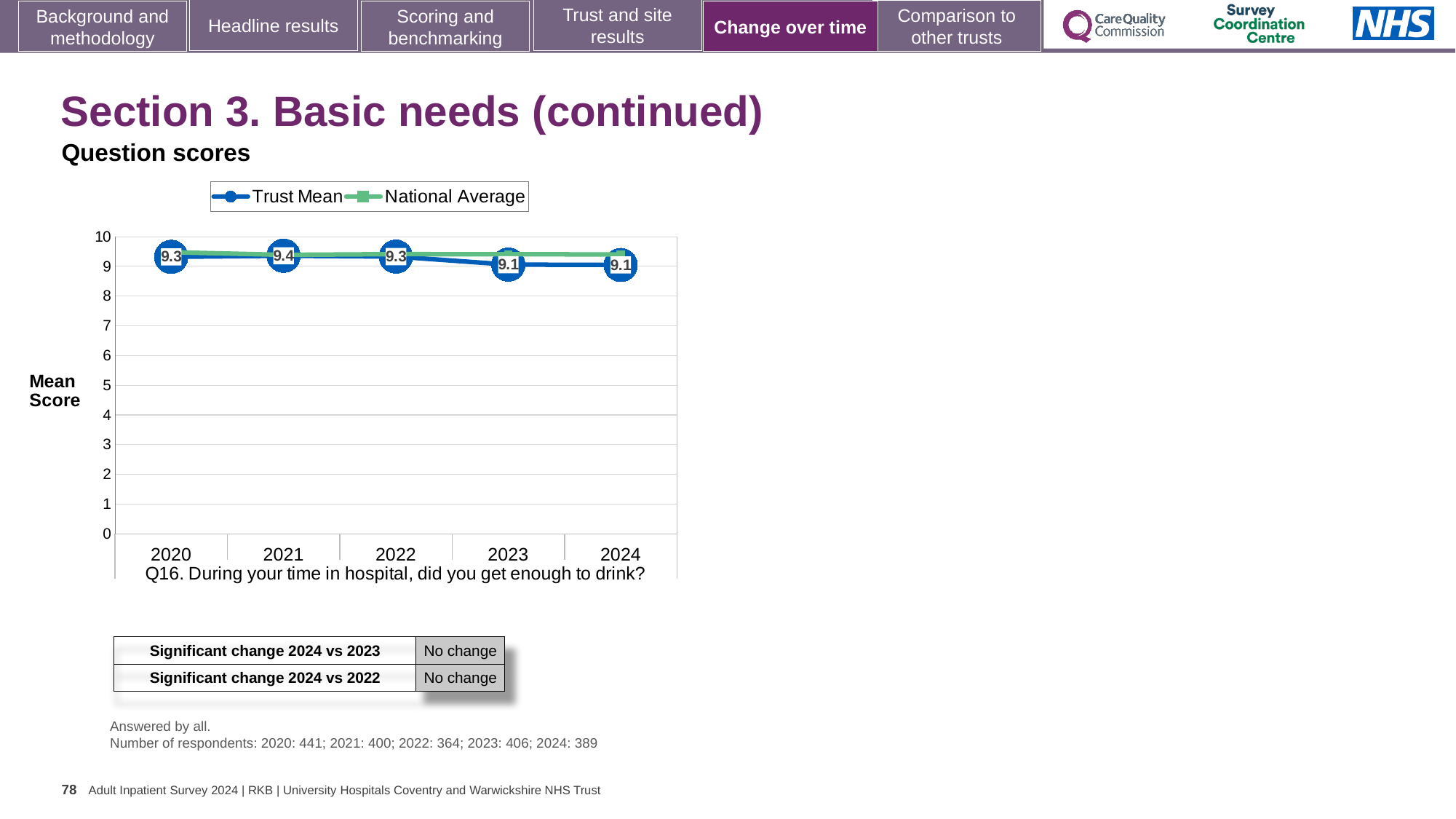
What is the Trust Mean score for 2024? 9.1 What is the difference between the Trust Mean score in 2021 and in 2024? 0.3 What is the Trust Mean score for 2021? 9.4 Is the National Average value for 2024 greater or less than 8? greater What kind of chart is shown on the slide? line chart How many years are plotted on the x axis? 5 Does the Trust Mean score rise or fall from 2021 to 2024? fall What is the Trust Mean score for 2020? 9.3 Which year has the larger Trust Mean score, 2021 or 2023? 2021 In which year is the Trust Mean score highest? 2021 How many series does the legend list? 2 What are the two series named in the legend? Trust Mean and National Average